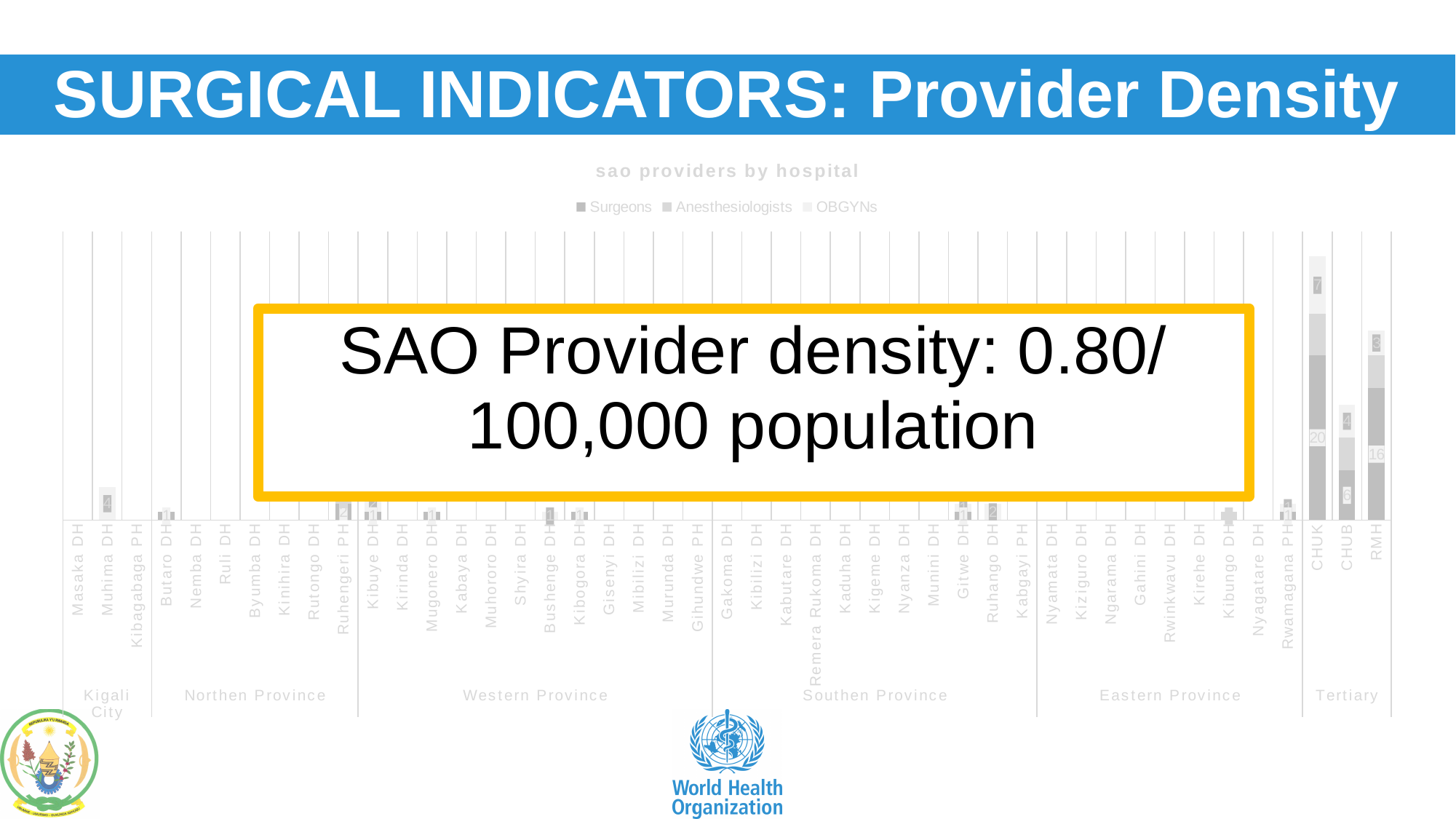
What is the value of the Surgeons segment for CHUB? 6 What is the title of the chart? sao providers by hospital Which hospital has the tallest bar in the chart? CHUK What is the difference between the Surgeons values for CHUK and RMH? 4 What kind of chart is shown on the slide? stacked bar chart Which series are listed in the chart legend? Surgeons, Anesthesiologists, OBGYNs Which hospital has a larger Surgeons value, CHUB or RMH? RMH Which group of hospitals on the x axis has the tallest bars? Tertiary What is the value of the top segment of the CHUK bar? 7 What is the value of the Surgeons segment for RMH? 16 What is the value of the Surgeons segment for CHUK? 20 How many series does the chart legend list? 3